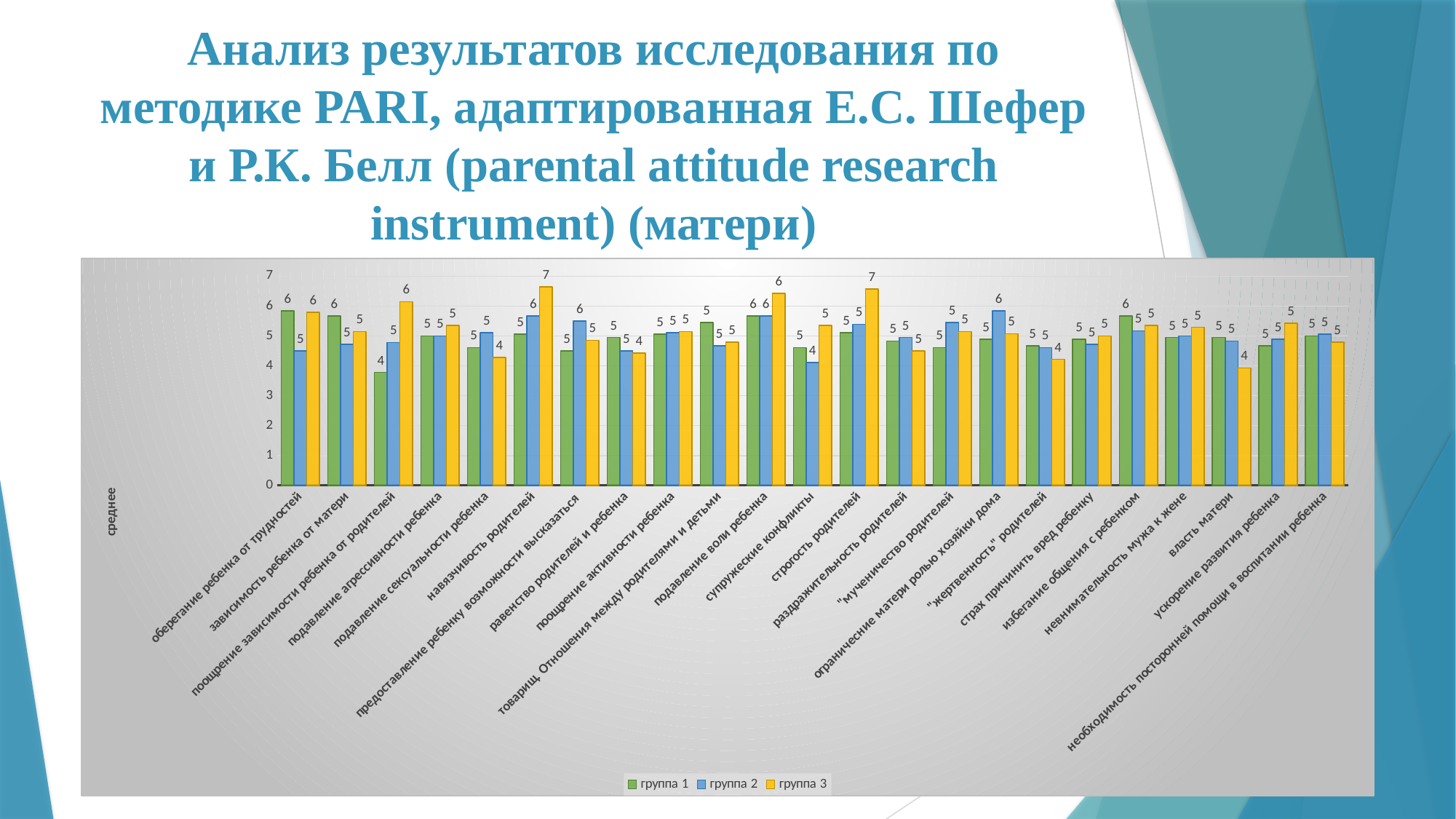
In the category "навязчивость родителей", which is larger: группа 1 or группа 3? группа 3 In which category does группа 2 have its lowest value? супружеские конфликты What is the value for группа 3 in the category "строгость родителей"? 7 How many categories are plotted along the x axis? 23 How many series does the legend list? 3 In the category "строгость родителей", what is the difference between the values for группа 3 and группа 1? 2 What is the value for группа 3 in the category "навязчивость родителей"? 7 What is the value for группа 2 in the category "супружеские конфликты"? 4 What is the value for группа 1 in the category "поощрение зависимости ребенка от родителей"? 4 In which category does группа 1 have its lowest value? поощрение зависимости ребенка от родителей What kind of chart is shown on the slide? bar chart What label is shown on the vertical axis of the chart? среднее